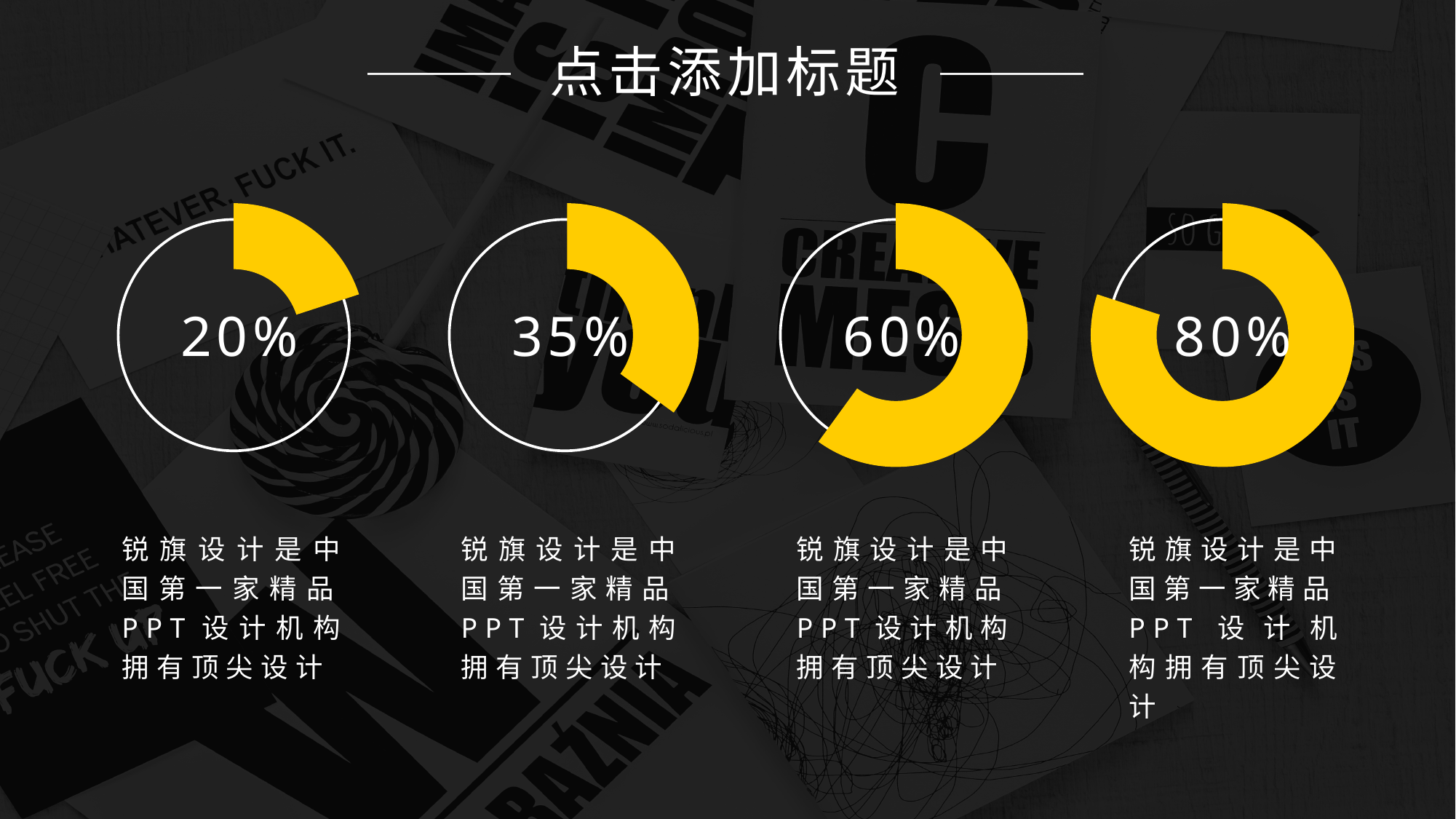
Which ring chart shows the highest percentage? The rightmost (80%) What percentage is shown in the leftmost ring chart? 20% Which ring chart shows the lowest percentage? The leftmost (20%) What percentage is shown in the second ring chart from the left? 35% What percentage is shown in the third ring chart from the left? 60% Do the percentages increase or decrease from left to right across the four ring charts? Increase How many ring charts are on the slide? 4 What percentage is shown in the rightmost ring chart? 80% Which is larger, the percentage in the second ring chart from the left or the third ring chart from the left? The third (60%) What is the difference between the percentages in the third and second ring charts from the left? 25% What is the difference between the percentages in the rightmost and leftmost ring charts? 60% What colour is the filled portion of each ring chart? Yellow